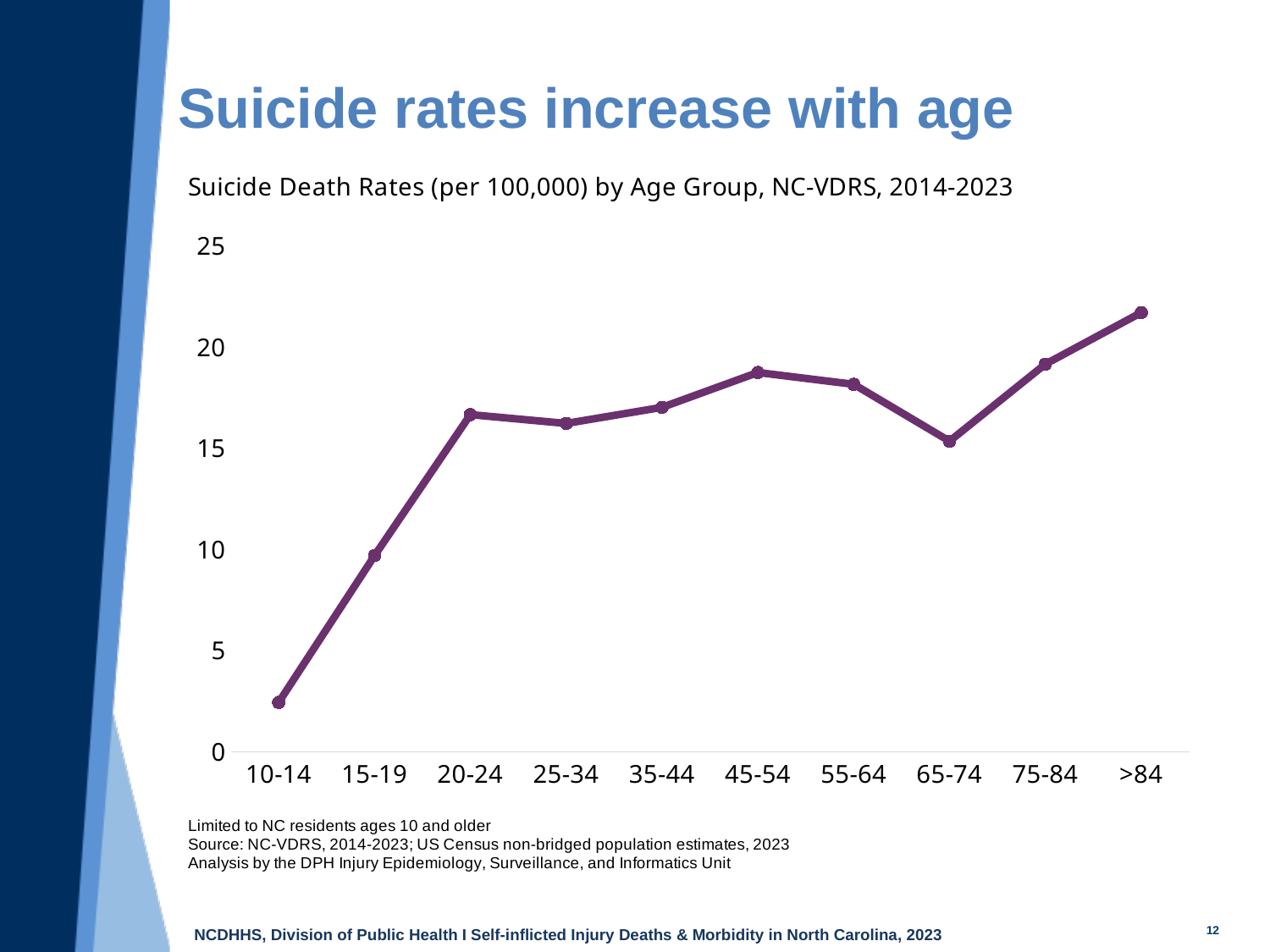
Which age group has the lowest suicide death rate? 10-14 What is the title of the chart? Suicide Death Rates (per 100,000) by Age Group, NC-VDRS, 2014-2023 Which age group has a higher suicide death rate, 15-19 or 20-24? 20-24 What type of chart is shown on the slide? Line chart Is the value for the 45-54 age group greater or less than 20? less Which age group has a higher suicide death rate, 45-54 or 65-74? 45-54 Is the value for the 10-14 age group greater or less than 5? less Is the value for the >84 age group greater or less than 20? greater How many age groups are plotted along the x axis? 10 Which age group has the highest suicide death rate? >84